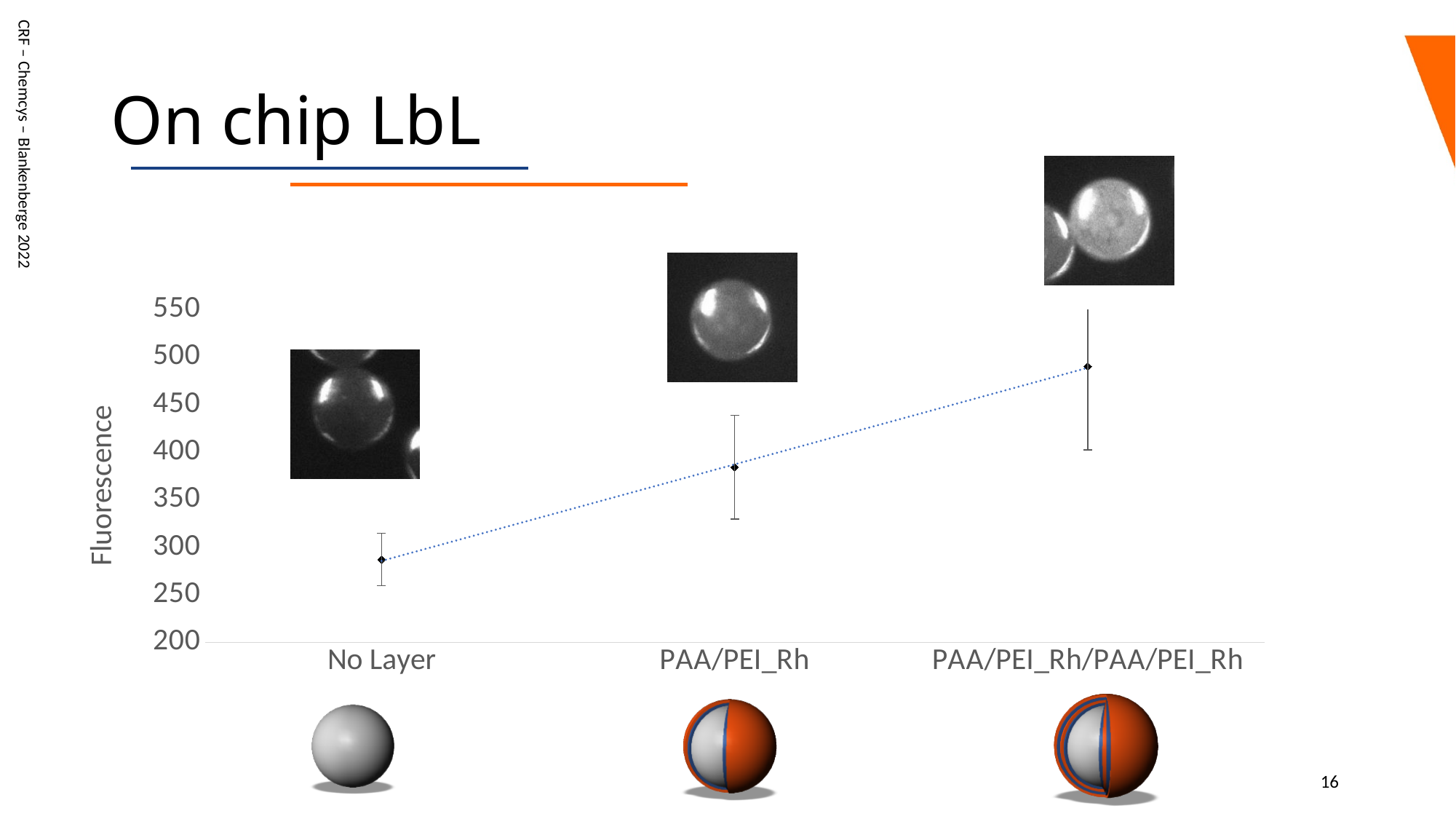
How many categories are plotted along the x axis of the chart? 3 Is the fluorescence value for No Layer greater or less than 300? less What is the lowest value shown on the y axis of the chart? 200 Which category has the lowest fluorescence value? No Layer Do the fluorescence values rise or fall from left to right along the x axis? rise What is the label of the y axis of the chart? Fluorescence Is the fluorescence value for PAA/PEI_Rh greater or less than 350? greater Which has the larger fluorescence value, No Layer or PAA/PEI_Rh? PAA/PEI_Rh What kind of chart is shown on the slide? line chart Which category has the highest fluorescence value? PAA/PEI_Rh/PAA/PEI_Rh Is the fluorescence value for PAA/PEI_Rh/PAA/PEI_Rh greater or less than 450? greater